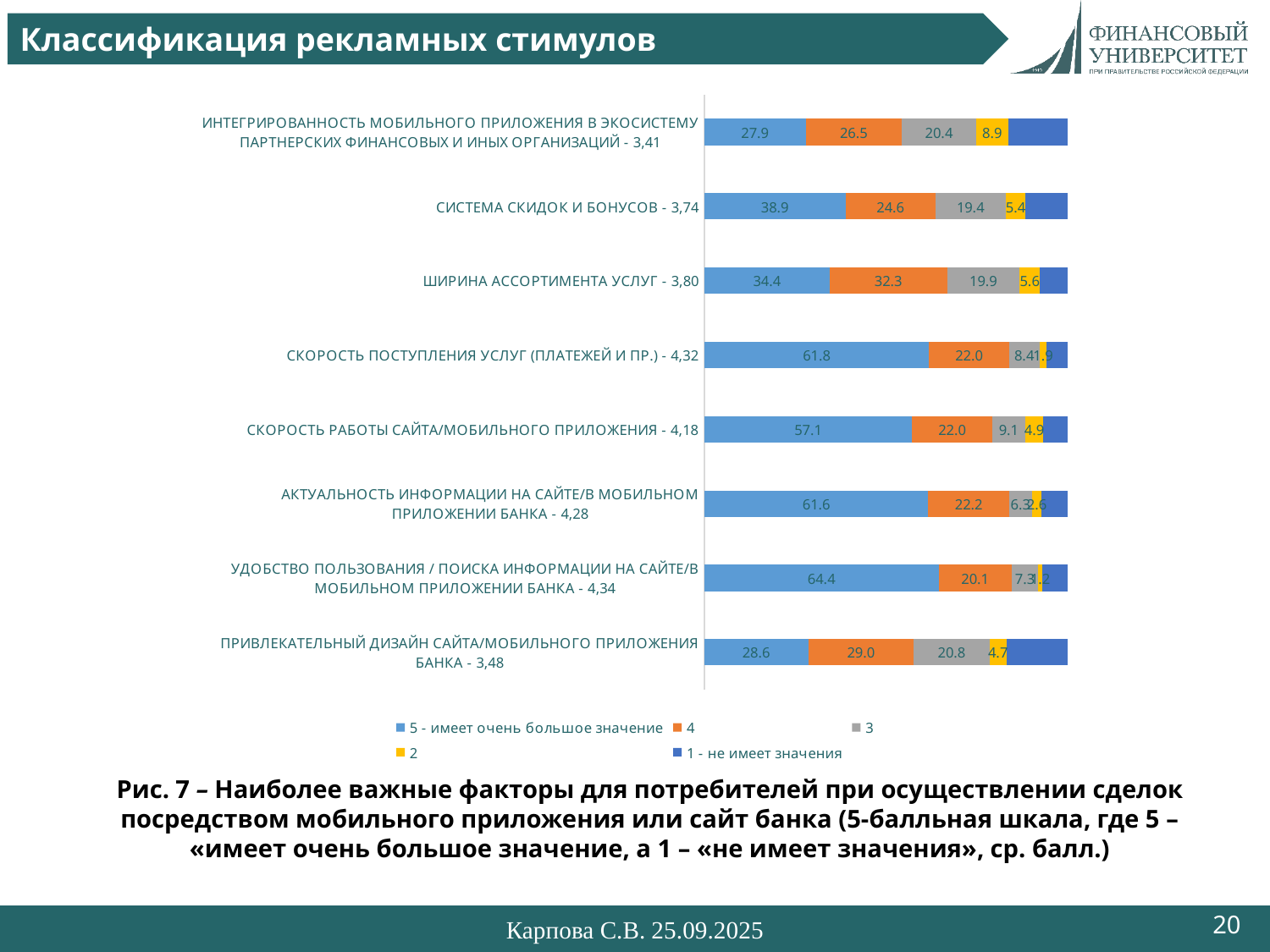
How many series does the legend list? 5 What is the value of the '2' segment for 'ИНТЕГРИРОВАННОСТЬ МОБИЛЬНОГО ПРИЛОЖЕНИЯ В ЭКОСИСТЕМУ ПАРТНЕРСКИХ ФИНАНСОВЫХ И ИНЫХ ОРГАНИЗАЦИЙ - 3,41'? 8.9 Which category has the highest value for the '5 - имеет очень большое значение' series? УДОБСТВО ПОЛЬЗОВАНИЯ / ПОИСКА ИНФОРМАЦИИ НА САЙТЕ/В МОБИЛЬНОМ ПРИЛОЖЕНИИ БАНКА - 4,34 What is the value of the '5 - имеет очень большое значение' segment for 'СИСТЕМА СКИДОК И БОНУСОВ - 3,74'? 38.9 What is the value of the '4' segment for 'ШИРИНА АССОРТИМЕНТА УСЛУГ - 3,80'? 32.3 What is the legend label for the dark blue series? 1 - не имеет значения Which is larger: the '4' value for 'ПРИВЛЕКАТЕЛЬНЫЙ ДИЗАЙН САЙТА/МОБИЛЬНОГО ПРИЛОЖЕНИЯ БАНКА - 3,48' or the '4' value for 'СИСТЕМА СКИДОК И БОНУСОВ - 3,74'? ПРИВЛЕКАТЕЛЬНЫЙ ДИЗАЙН САЙТА/МОБИЛЬНОГО ПРИЛОЖЕНИЯ БАНКА - 3,48 What is the value of the '3' segment for 'ПРИВЛЕКАТЕЛЬНЫЙ ДИЗАЙН САЙТА/МОБИЛЬНОГО ПРИЛОЖЕНИЯ БАНКА - 3,48'? 20.8 What kind of chart is shown on the slide? Stacked bar chart What is the difference between the '5 - имеет очень большое значение' values for 'СКОРОСТЬ ПОСТУПЛЕНИЯ УСЛУГ (ПЛАТЕЖЕЙ И ПР.) - 4,32' and 'СКОРОСТЬ РАБОТЫ САЙТА/МОБИЛЬНОГО ПРИЛОЖЕНИЯ - 4,18'? 4.7 Which category has the lowest value for the '5 - имеет очень большое значение' series? ИНТЕГРИРОВАННОСТЬ МОБИЛЬНОГО ПРИЛОЖЕНИЯ В ЭКОСИСТЕМУ ПАРТНЕРСКИХ ФИНАНСОВЫХ И ИНЫХ ОРГАНИЗАЦИЙ - 3,41 How many categories are shown in the chart? 8